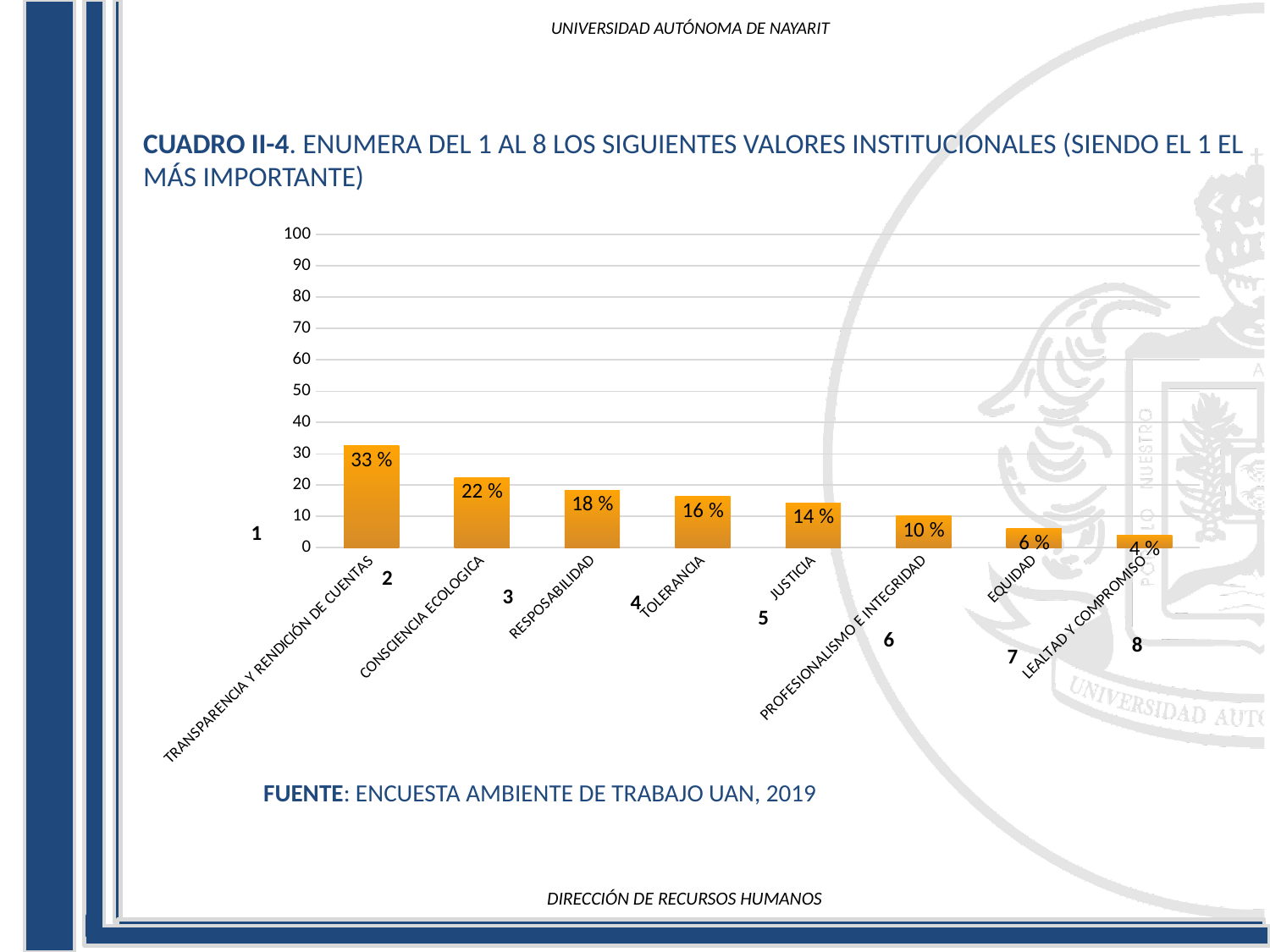
What is the value for LEALTAD Y COMPROMISO? 4 % What is the value for CONSCIENCIA ECOLOGICA? 22 % What is the value for JUSTICIA? 14 % What is the value for TRANSPARENCIA Y RENDICIÓN DE CUENTAS? 33 % Which is larger, the value for PROFESIONALISMO E INTEGRIDAD or the value for EQUIDAD? PROFESIONALISMO E INTEGRIDAD How many categories are shown in the chart? 8 What is the difference between the values for RESPOSABILIDAD and TOLERANCIA? 2 % What kind of chart is shown on the slide? bar chart Which category has the lowest value? LEALTAD Y COMPROMISO Is the value for CONSCIENCIA ECOLOGICA greater or less than 30? less Do the values rise or fall from left to right along the x axis? fall Which category has the highest value? TRANSPARENCIA Y RENDICIÓN DE CUENTAS